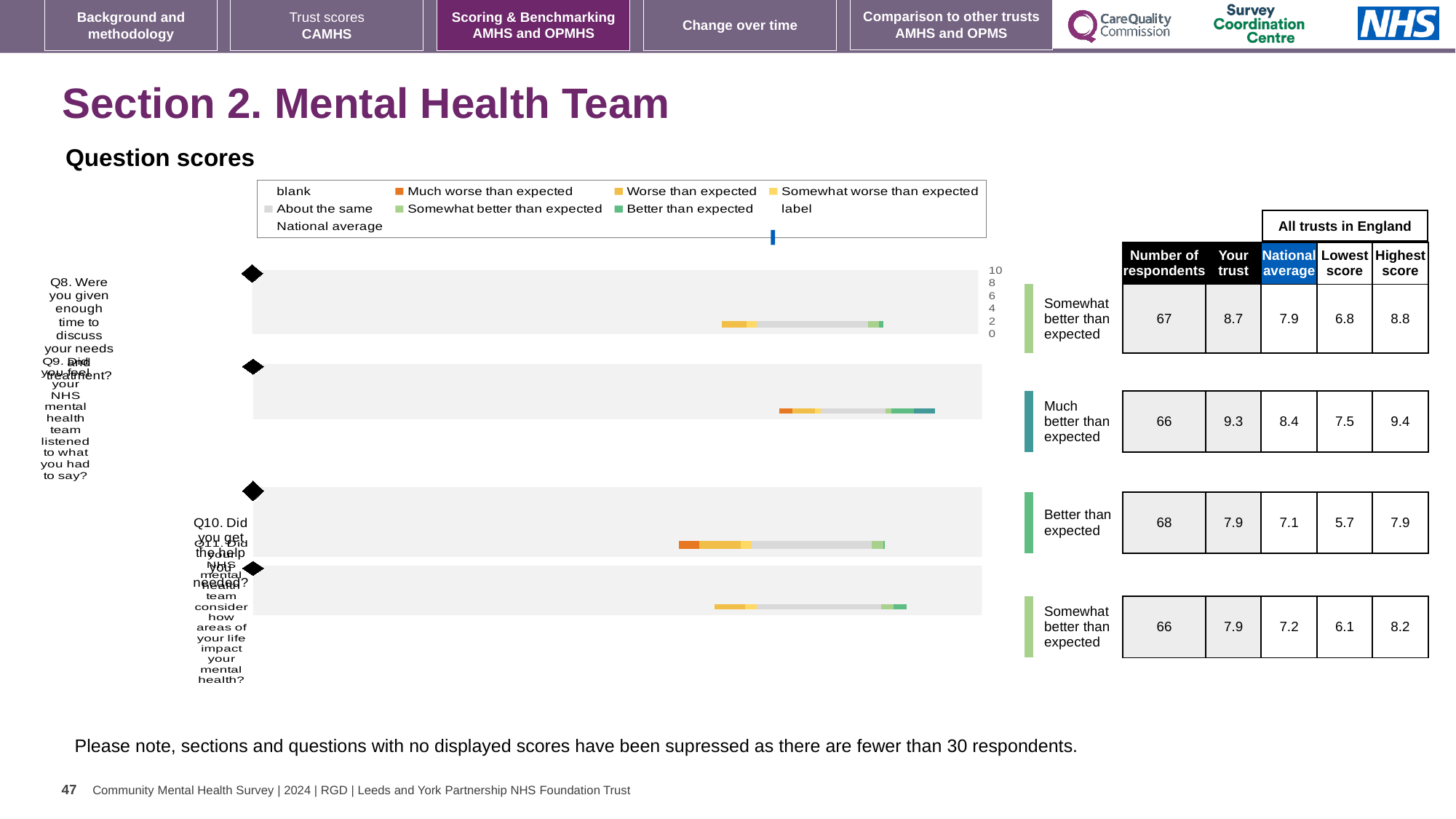
What is the difference between the 'Your trust' score and the national average for the first row (Q8)? 0.8 What benchmark label is shown beside the second bar (Q9)? Much better than expected Which row in the table has the lowest 'Lowest score' value? Q10 (5.7) In the table next to the chart, what is the 'Your trust' score for the first row (Q8)? 8.7 What kind of chart is used to show the question scores on this slide? bar chart In the table next to the chart, what is the highest score for the third row (Q10)? 7.9 Is the 'Your trust' score larger for the first row (Q8) or the second row (Q9)? Q9 Which row in the table has the highest 'Your trust' score? Q9 (9.3) What is the heading above the 'National average', 'Lowest score' and 'Highest score' columns in the table? All trusts in England How many question bars are plotted in the question scores chart? 4 In the table next to the chart, what is the national average for the fourth row (Q11)? 7.2 In the table next to the chart, what is the number of respondents for the second row (Q9)? 66